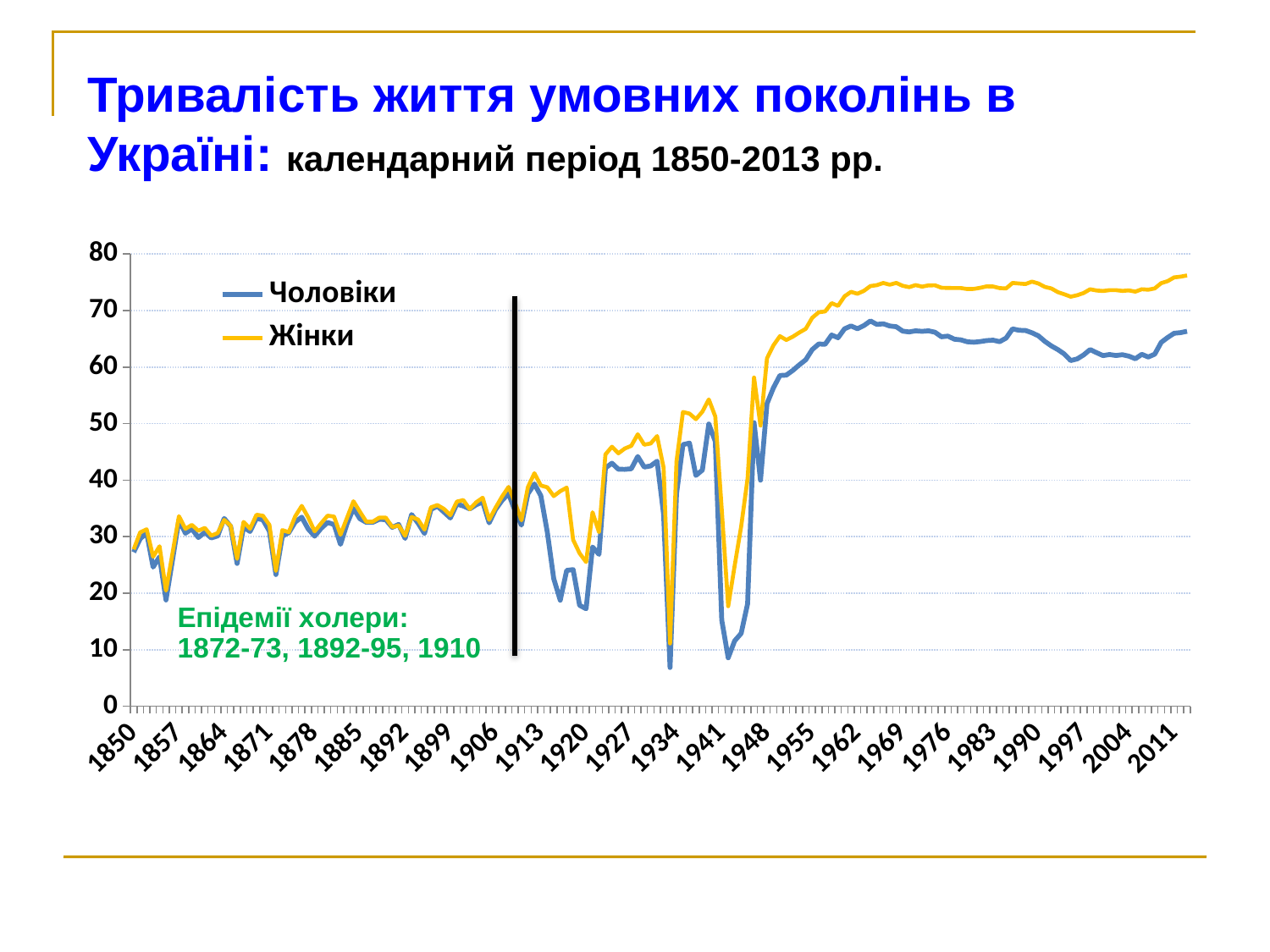
Is the value for Чоловіки larger in 1850 or in 2011? 2011 Which years does the green annotation give for the cholera epidemics (Епідемії холери)? 1872-73, 1892-95, 1910 What are the two series named in the legend? Чоловіки, Жінки How many series does the legend list? 2 Is the value for Чоловіки in 1990 greater or less than 60? greater What kind of chart is shown on the slide? line chart Overall, do the values for Жінки rise or fall from 1850 to 2011? rise Is the value for Чоловіки in 2011 greater or less than 60? greater Is the value for Чоловіки in 1850 greater or less than 40? less Which series has the higher value in 2011, Чоловіки or Жінки? Жінки